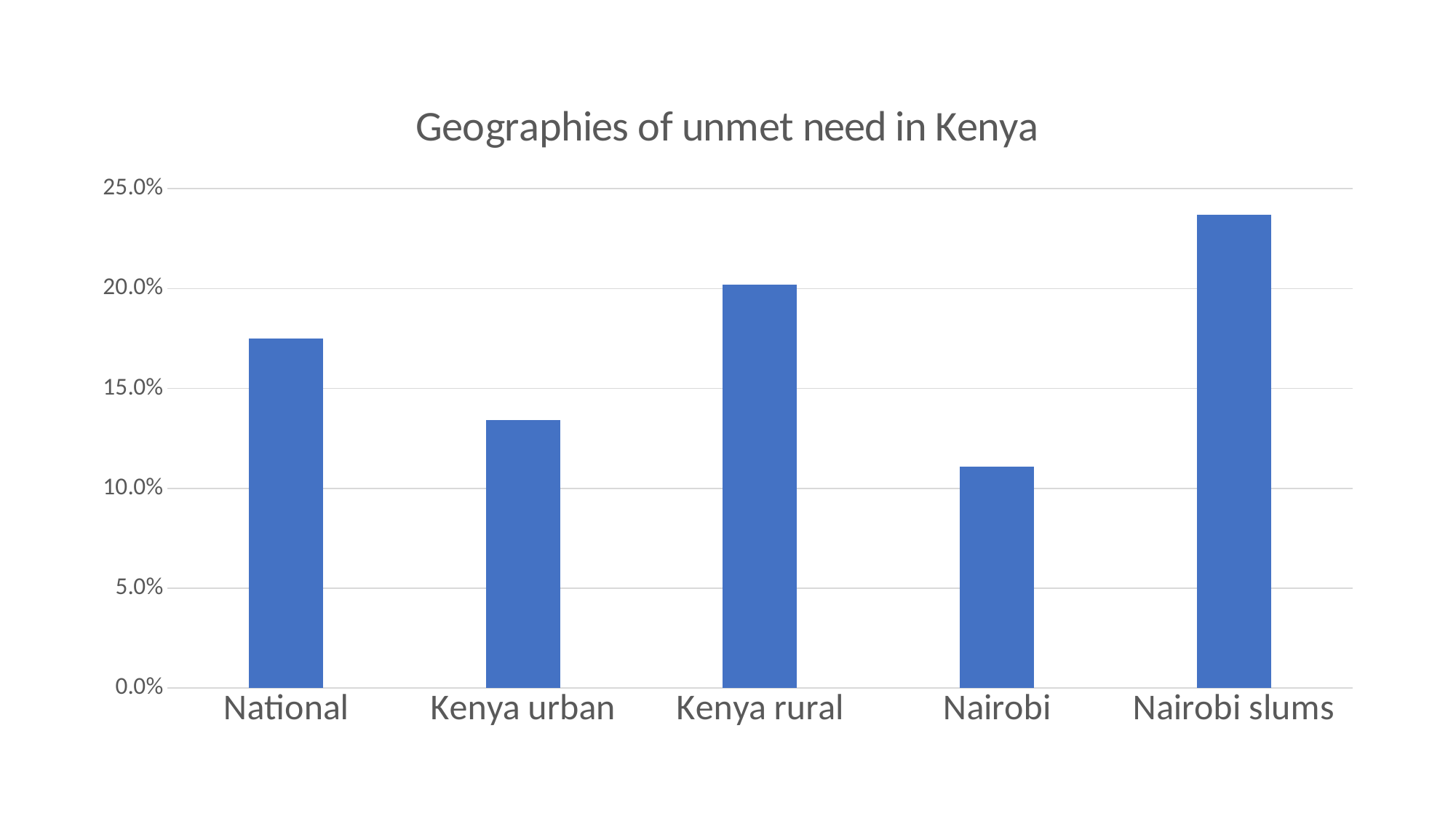
Is the value for Nairobi slums greater or less than 20.0%? greater What type of chart is shown on the slide? bar chart Which is larger, the value for Kenya rural or the value for National? Kenya rural How many categories are shown on the x axis? 5 What is the title of the chart? Geographies of unmet need in Kenya Which is larger, the value for Nairobi or the value for Kenya urban? Kenya urban Which category has the highest value? Nairobi slums Is the value for Nairobi greater or less than 15.0%? less Is the value for Kenya rural greater or less than 15.0%? greater Which category has the lowest value? Nairobi